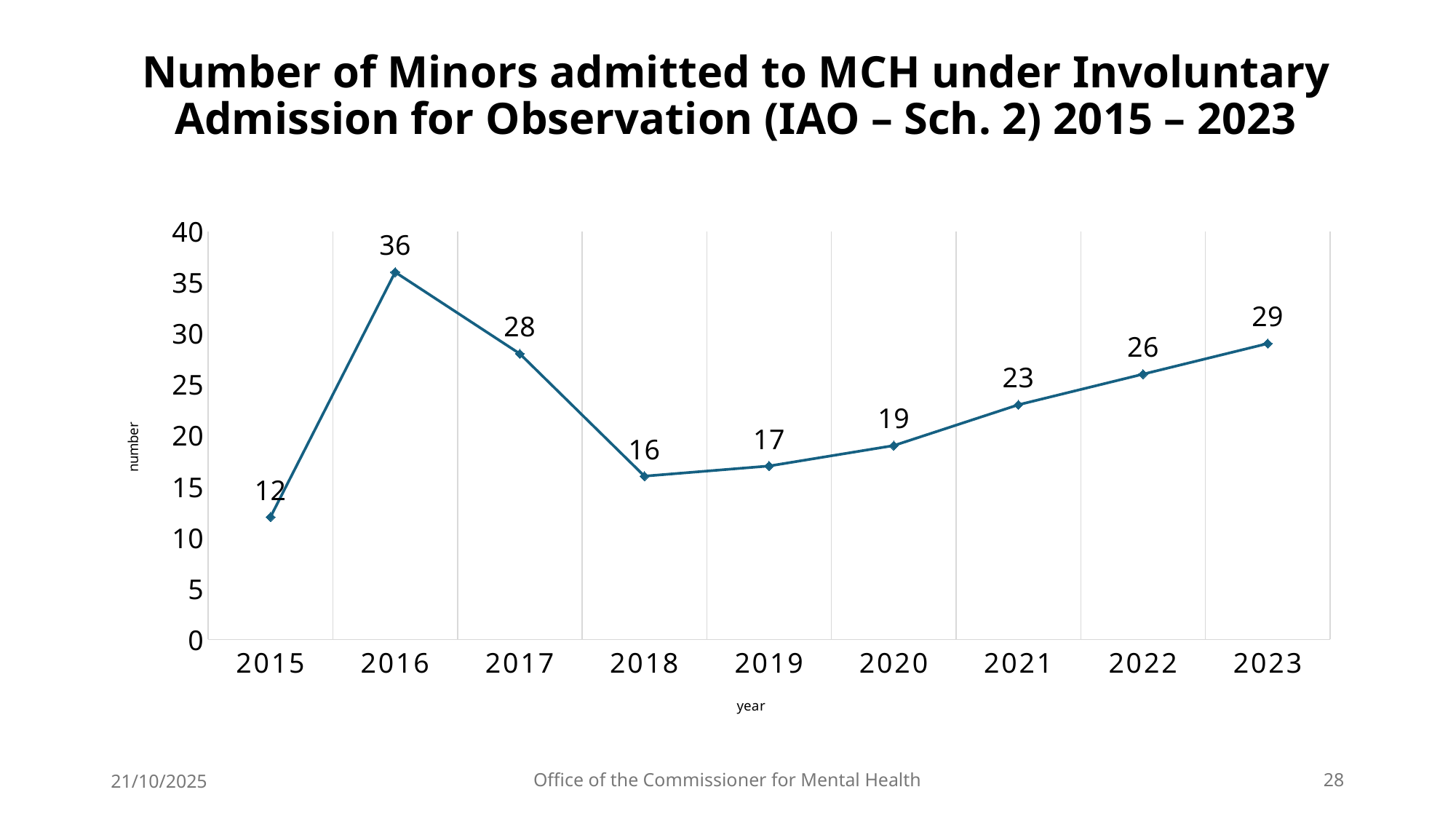
Which year has the highest number of minors admitted under IAO? 2016 Do the values rise or fall from 2018 to 2023? Rise What is the difference between the number of admissions in 2023 and in 2018? 13 Is the value for 2021 greater or less than 20? greater Which year has the lowest number of minors admitted under IAO? 2015 What is the difference between the number of admissions in 2016 and in 2015? 24 What is the number of minors admitted under IAO in 2023? 29 How many years are plotted on the chart? 9 Which year had more admissions, 2017 or 2022? 2017 What is the number of minors admitted under IAO in 2019? 17 What kind of chart is shown on the slide? Line chart What is the number of minors admitted under IAO in 2016? 36